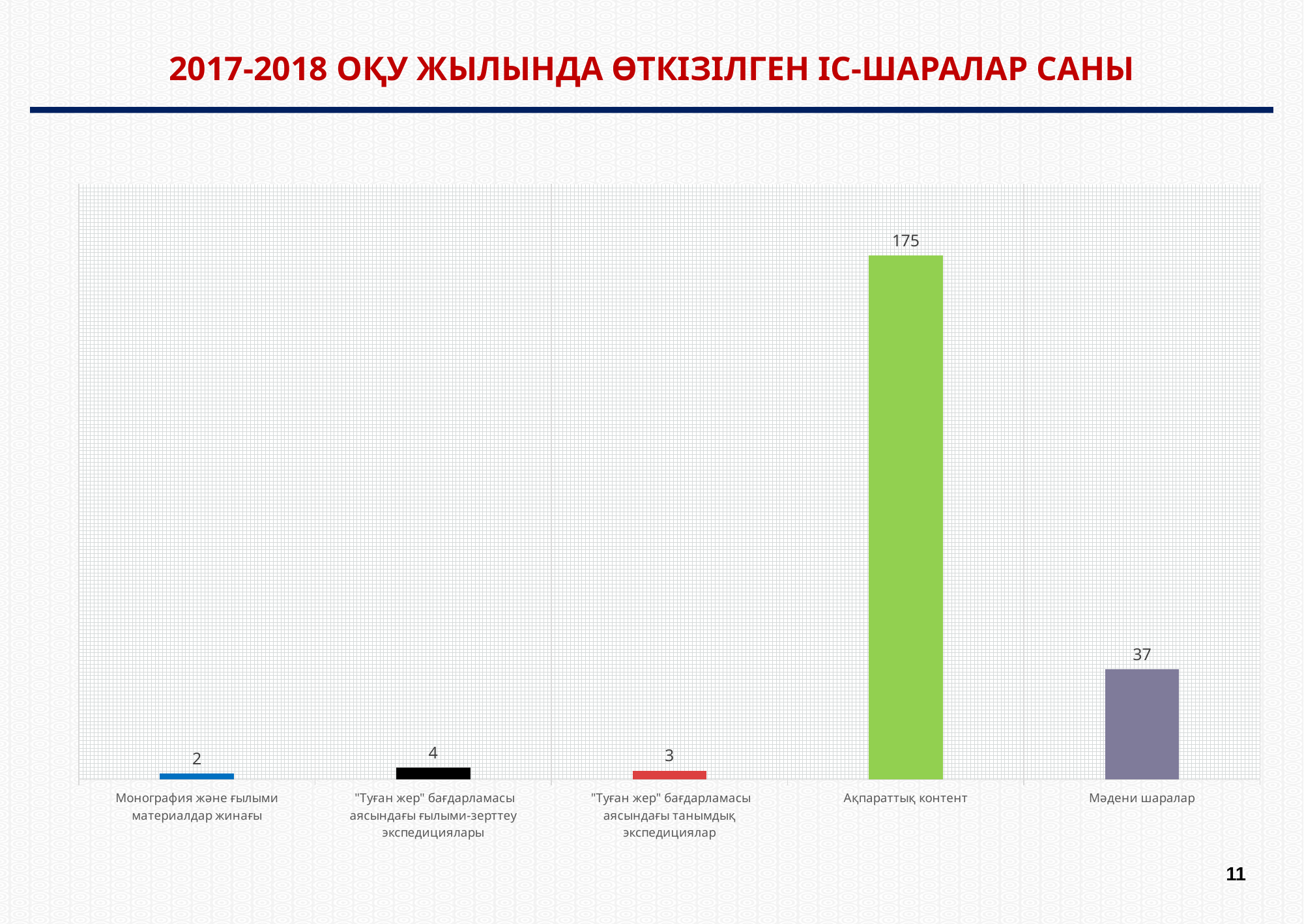
What is the value for Мәдени шаралар? 37 Which category has the highest value? Ақпараттық контент What is the value for "Туған жер" бағдарламасы аясындағы ғылыми-зерттеу экспедициялары? 4 What is the value for Монография және ғылыми материалдар жинағы? 2 Which category has the lowest value? Монография және ғылыми материалдар жинағы What is the title of the slide? 2017-2018 ОҚУ ЖЫЛЫНДА ӨТКІЗІЛГЕН ІС-ШАРАЛАР САНЫ Which is larger: the value for "Туған жер" бағдарламасы аясындағы ғылыми-зерттеу экспедициялары or the value for "Туған жер" бағдарламасы аясындағы танымдық экспедициялар? "Туған жер" бағдарламасы аясындағы ғылыми-зерттеу экспедициялары What is the value for Ақпараттық контент? 175 What is the value for "Туған жер" бағдарламасы аясындағы танымдық экспедициялар? 3 How many categories are shown in the chart? 5 What kind of chart is shown on the slide? Bar chart What is the difference between the values for Ақпараттық контент and Мәдени шаралар? 138